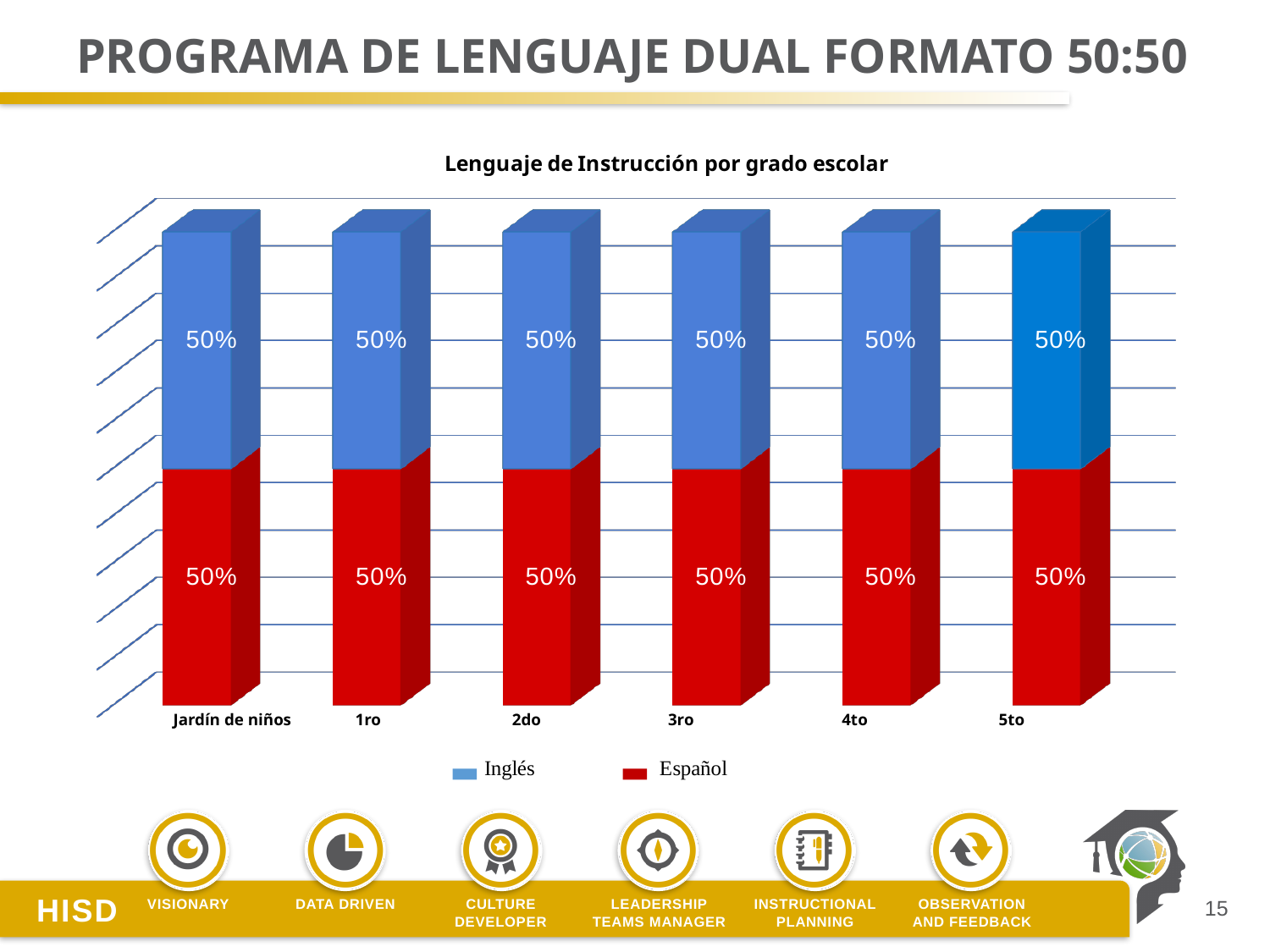
How many series does the legend list? 2 What is the Inglés value for Jardín de niños? 50% What is the difference between the Inglés and Español values for 4to? 0% What is the title of the chart? Lenguaje de Instrucción por grado escolar What kind of chart is shown on the slide? stacked bar chart What is the total of the stacked bar for 2do? 100% What is the Español value for 1ro? 50% Do the Inglés values rise, fall, or stay the same from Jardín de niños to 5to? stay the same What is the Inglés value for 5to? 50% What is the Español value for 3ro? 50% Which two series are listed in the legend? Inglés and Español How many grade levels (categories) are shown on the x axis? 6